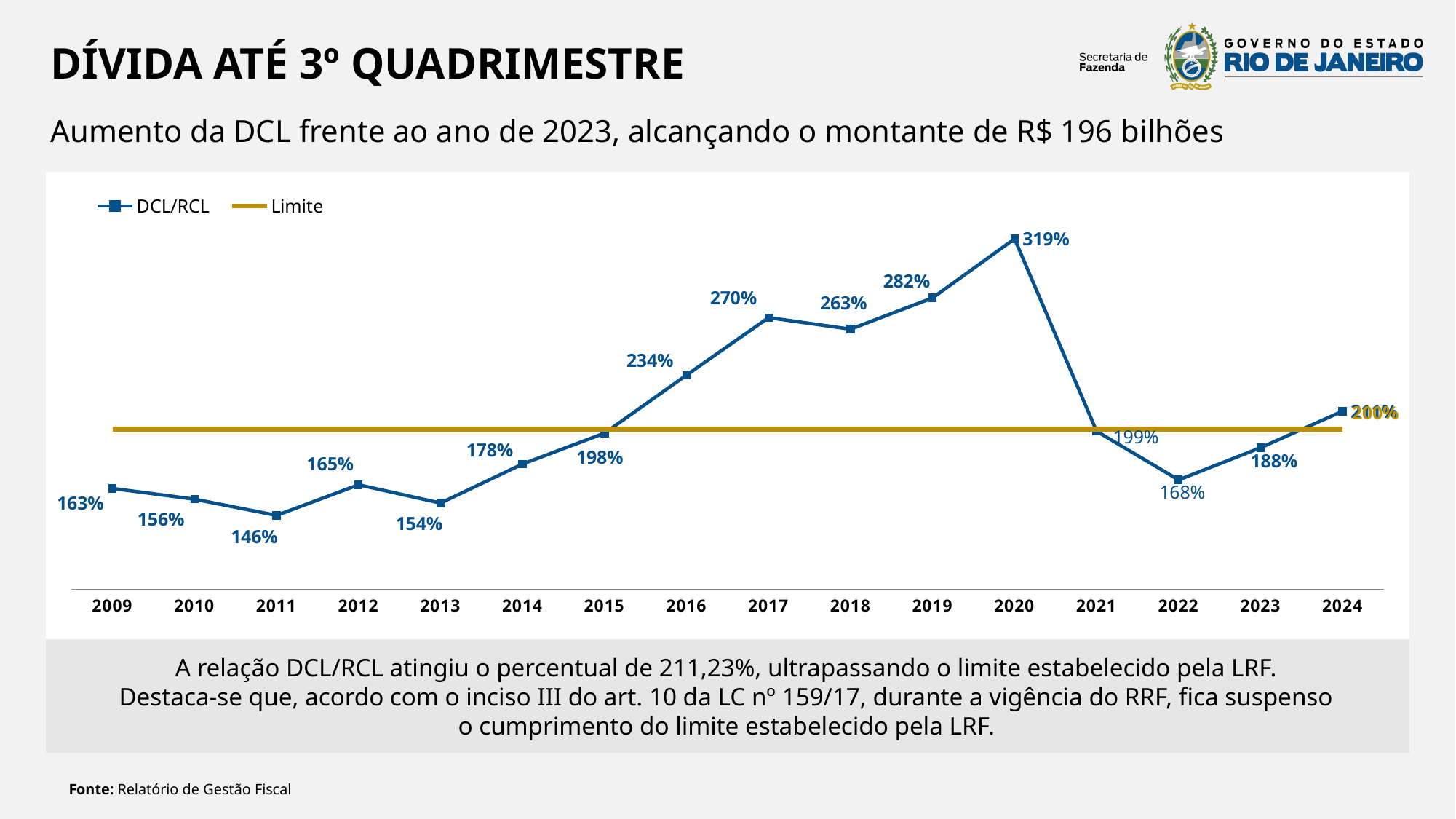
Which year has the highest DCL/RCL value? 2020 What is the DCL/RCL value for 2022? 168% What kind of chart is shown on the slide? Line chart What is the difference between the DCL/RCL values for 2020 and 2021? 120% What is the DCL/RCL value for 2011? 146% What is the DCL/RCL value for 2020? 319% Which year has a higher DCL/RCL value, 2017 or 2018? 2017 How many years are shown on the x axis of the chart? 16 How many series does the chart legend list? 2 Which year has the lowest DCL/RCL value? 2011 Does the DCL/RCL value rise or fall from 2013 to 2020? Rise What is the DCL/RCL value for 2015? 198%